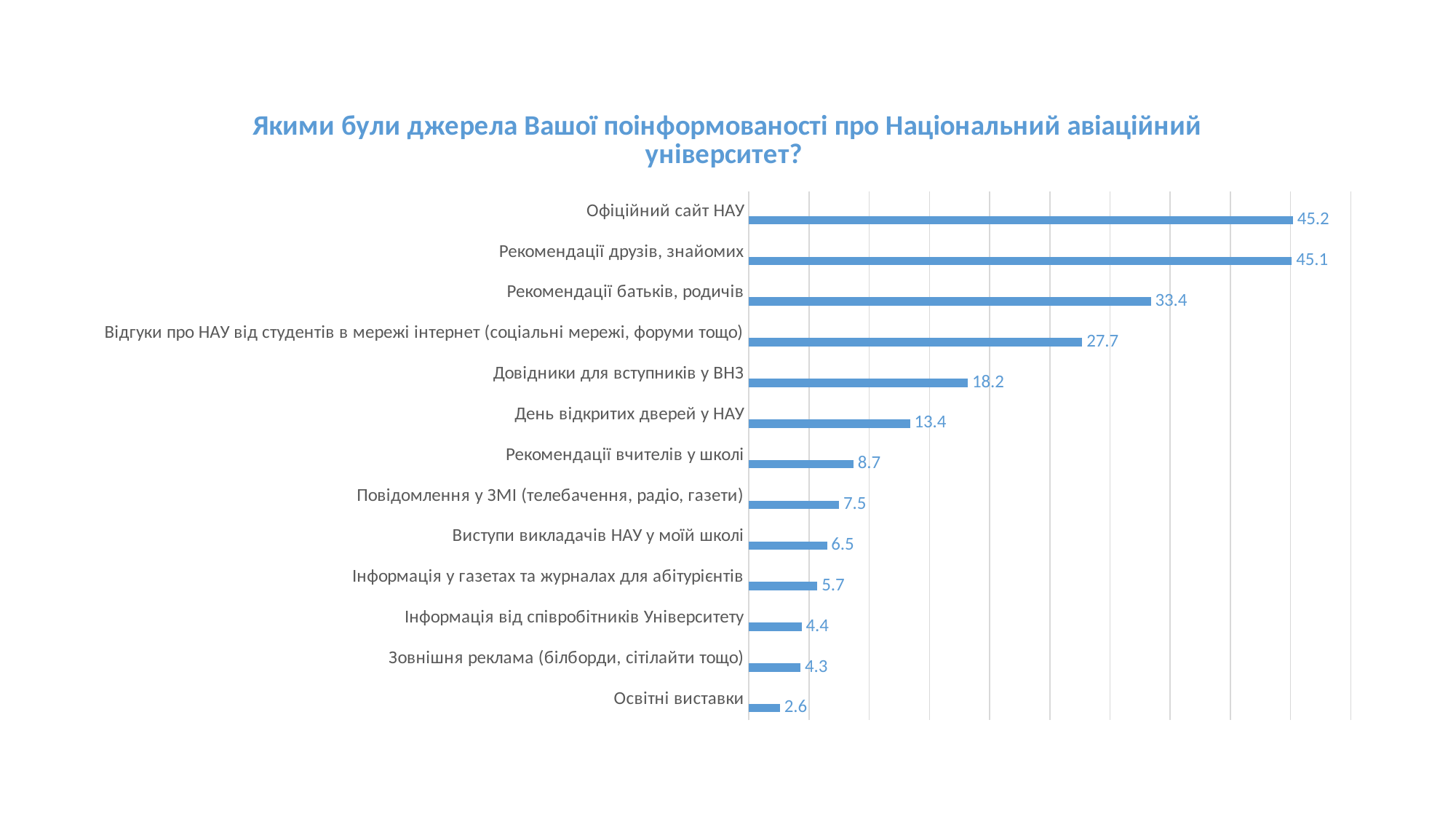
What is the title of the chart? Якими були джерела Вашої поінформованості про Національний авіаційний університет? What value is shown for "Відгуки про НАУ від студентів в мережі інтернет (соціальні мережі, форуми тощо)"? 27.7 Which is larger: the value for "Рекомендації вчителів у школі" or the value for "Виступи викладачів НАУ у моїй школі"? Рекомендації вчителів у школі What value is shown for "Офіційний сайт НАУ"? 45.2 What value is shown for "Довідники для вступників у ВНЗ"? 18.2 What kind of chart is shown on the slide? Bar chart What is the difference between the values for "Довідники для вступників у ВНЗ" and "День відкритих дверей у НАУ"? 4.8 What value is shown for "Зовнішня реклама (білборди, сітілайти тощо)"? 4.3 Which category has the lowest value? Освітні виставки How many categories are shown in the chart? 13 Which category has the highest value? Офіційний сайт НАУ What is the difference between the values for "Офіційний сайт НАУ" and "Рекомендації батьків, родичів"? 11.8